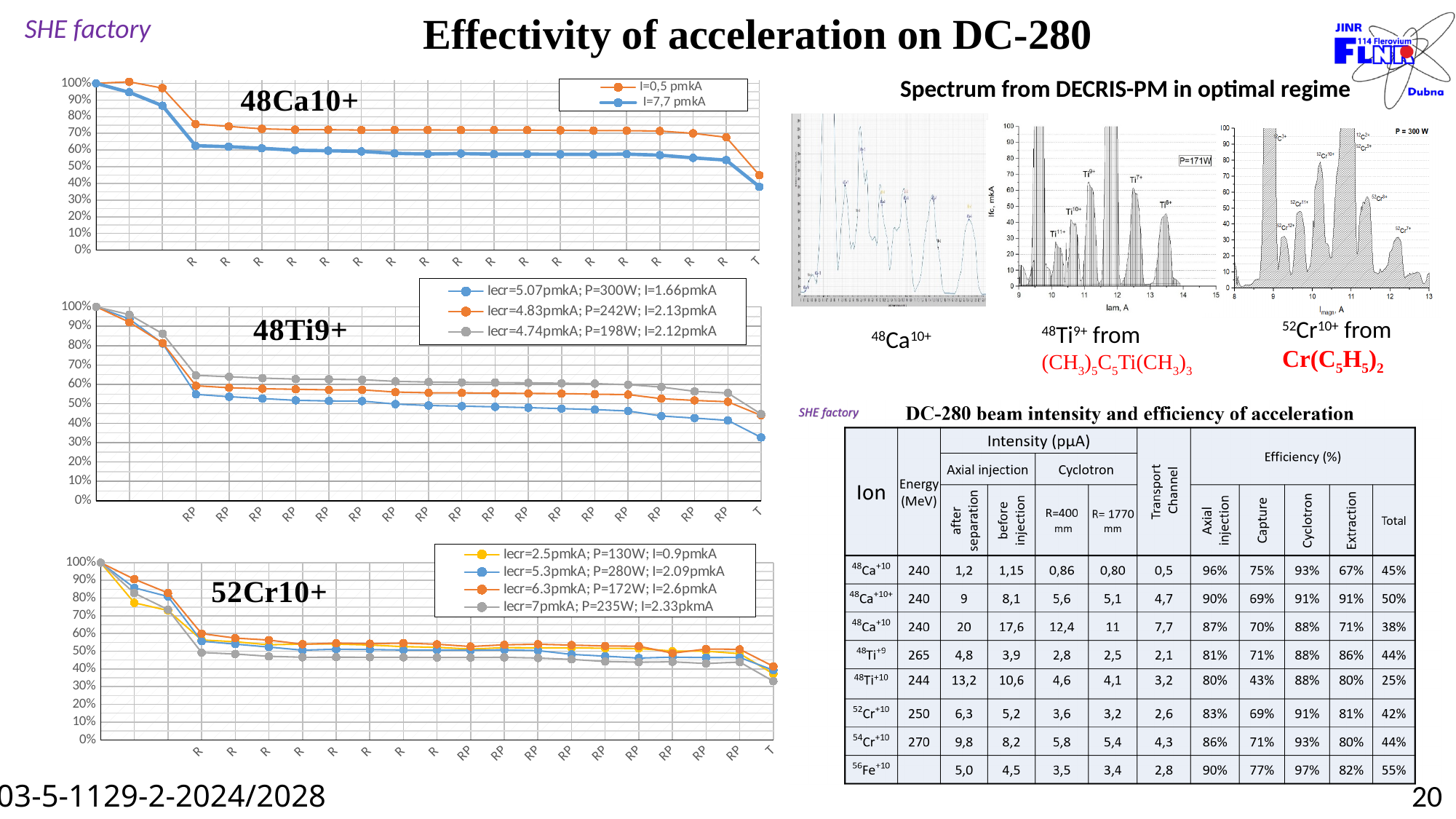
What kind of chart is the 48Ca10+ chart? line chart In the 48Ca10+ chart, is the value of the I=0,5 pmkA series at the last point (T) greater or less than 40%? greater In the 48Ca10+ chart, do the values rise or fall from left to right along the x axis? fall In the 52Cr10+ chart, is the value of the Iecr=7pmkA; P=235W; I=2.33pkmA series at the last point (T) greater or less than 40%? less In the 48Ti9+ chart, is the value of the Iecr=5.07pmkA; P=300W; I=1.66pmkA series at the last point (T) greater or less than 40%? less How many series does the legend of the 52Cr10+ chart list? 4 In the 48Ca10+ chart, which series is higher across the middle of the x axis, I=0,5 pmkA or I=7,7 pmkA? I=0,5 pmkA How many series does the legend of the 48Ti9+ chart list? 3 In the 48Ti9+ chart, which series is lowest across the middle of the x axis? Iecr=5.07pmkA; P=300W; I=1.66pmkA What is the highest value shown on the y axis of the 52Cr10+ chart? 100% How many series does the legend of the 48Ca10+ chart list? 2